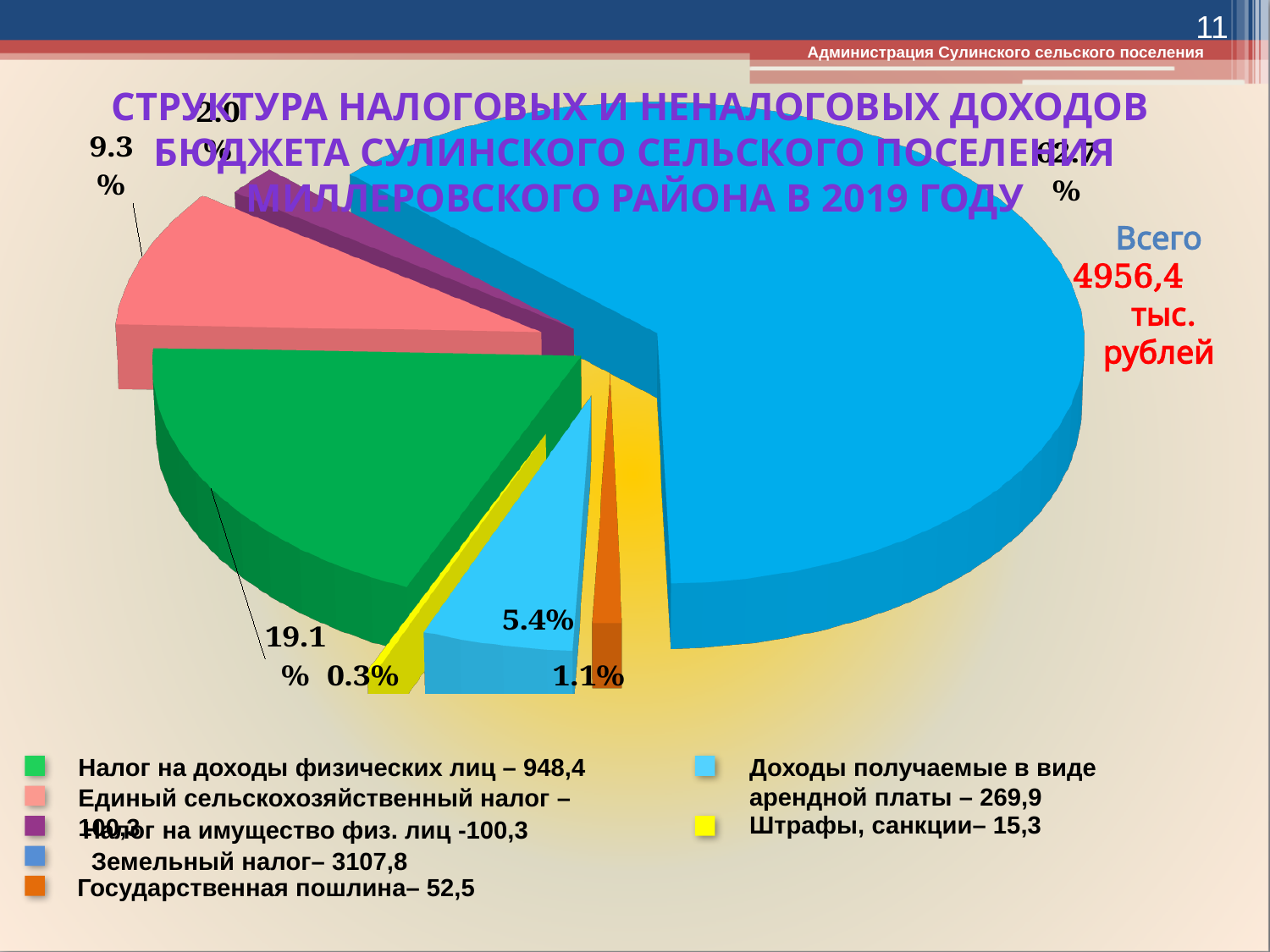
What is the difference in percentage points between the share of Земельный налог and the share of Налог на доходы физических лиц? 43.6 What is the total (Всего) shown on the slide? 4956,4 тыс. рублей What value is given in the legend for Земельный налог? 3107,8 Which category has the smallest share of the pie? Штрафы, санкции Which has the larger share: Доходы получаемые в виде арендной платы or Государственная пошлина? Доходы получаемые в виде арендной платы What share of the pie does Земельный налог have? 62.7% What share of the pie does Налог на доходы физических лиц have? 19.1% Which category has the largest share of the pie? Земельный налог How many slices does the pie chart have? 7 What value is given in the legend for Штрафы, санкции? 15,3 What kind of chart is shown on the slide? pie chart What value is given in the legend for Государственная пошлина? 52,5